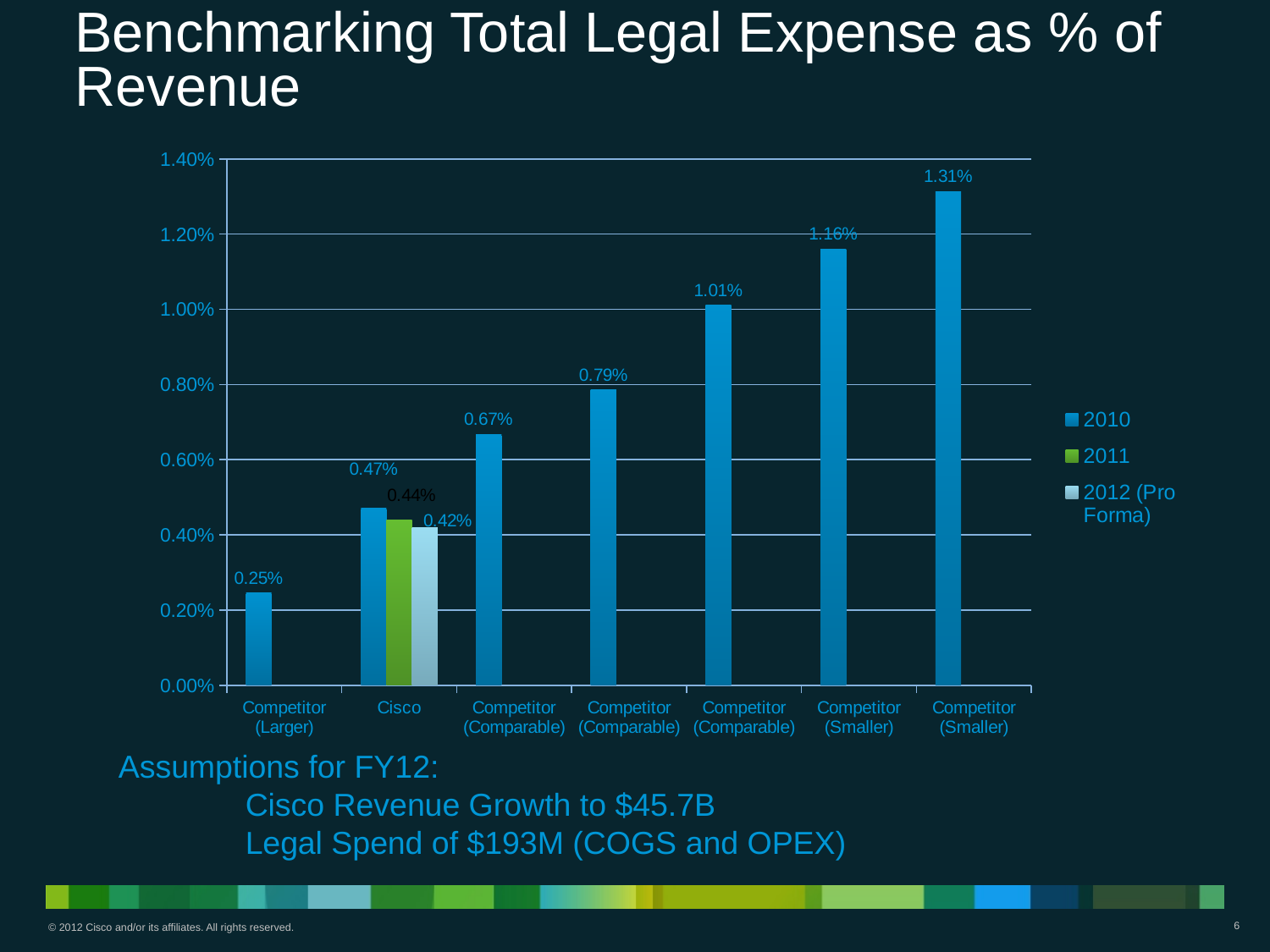
Which category has the highest value on the chart? Competitor (Smaller) (rightmost) How many series does the legend list? 3 What is Cisco's 2011 value? 0.44% What is Cisco's 2010 value? 0.47% Which category has the lowest value on the chart? Competitor (Larger) Do Cisco's values rise or fall from 2010 to 2012 (Pro Forma)? Fall Which is larger: the value for Competitor (Larger) or Cisco's 2011 value? Cisco's 2011 value What is the difference between Cisco's 2010 value and its 2012 (Pro Forma) value? 0.05% What is Cisco's 2012 (Pro Forma) value? 0.42% What is the value of the rightmost Competitor (Smaller) bar? 1.31% What is the 2010 value for Competitor (Larger)? 0.25% What kind of chart is shown on the slide? Bar chart